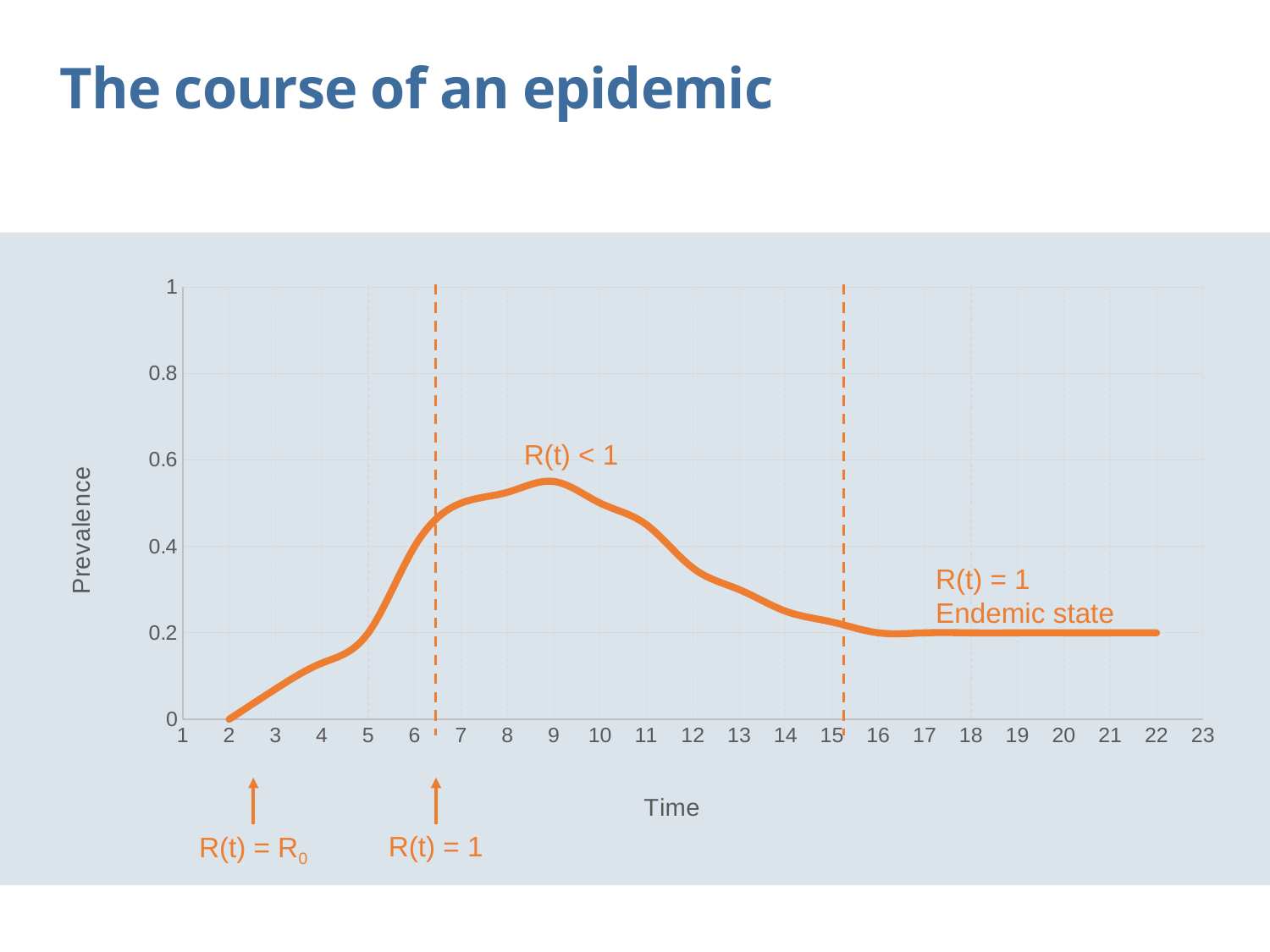
Is the prevalence at time 12 greater or less than 0.4? less What kind of chart is shown on the slide? line chart What is the prevalence value at time 2? 0 Does prevalence rise or fall between time 9 and time 16? fall Does prevalence rise or fall between time 2 and time 9? rise What is the label of the x axis? Time What is the label of the y axis? Prevalence Is the prevalence at time 9 greater or less than 0.6? less Which is larger, the prevalence at time 5 or at time 12? time 12 Which is larger, the prevalence at time 7 or at time 14? time 7 Is the prevalence at time 9 greater or less than 0.4? greater